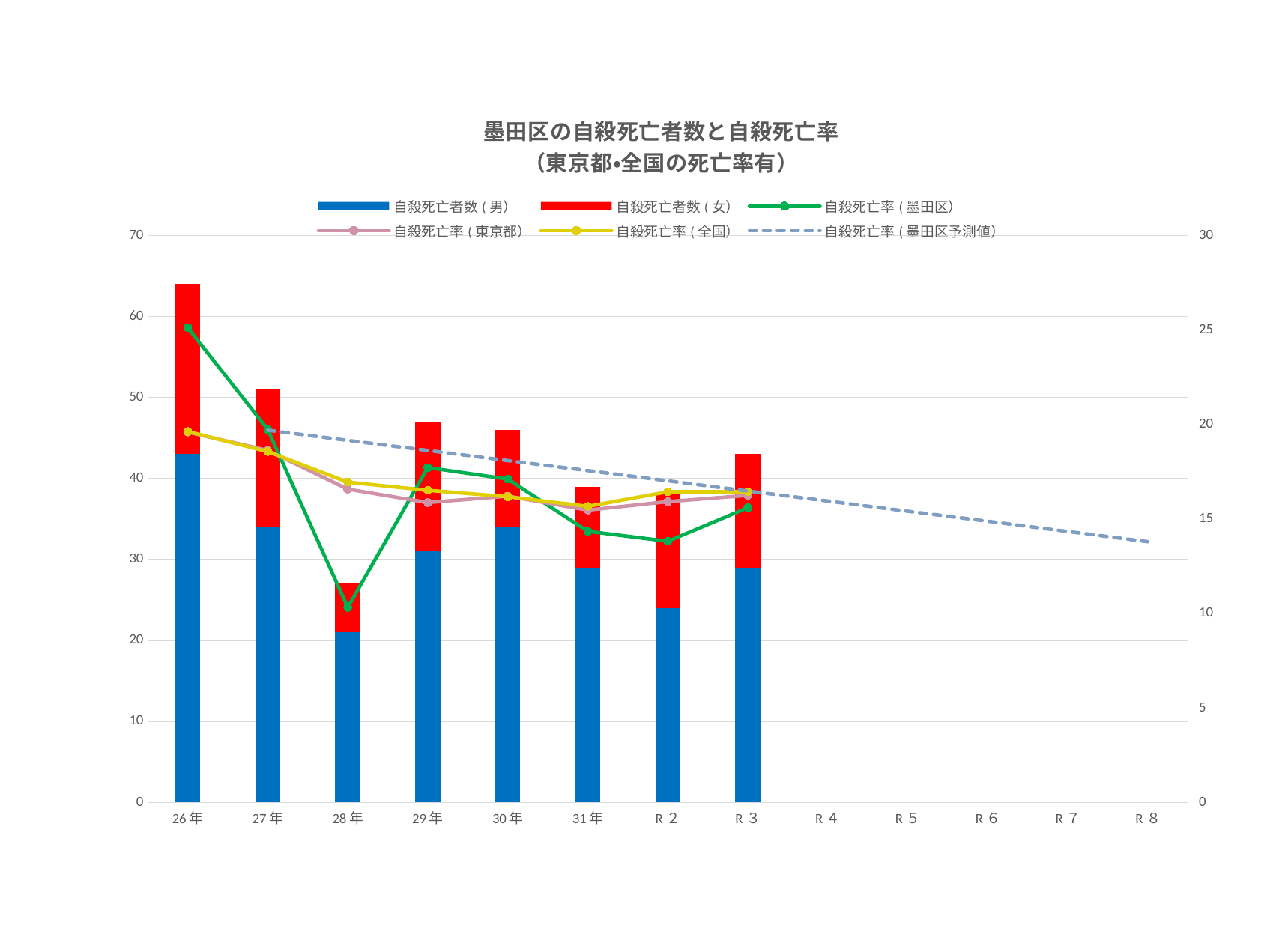
In which year does the 自殺死亡率(墨田区) line reach its lowest point? 28年 How many categories are shown on the x axis? 13 Is the total stacked bar for 28年 greater or less than 30? less How many series does the legend list? 6 What kind of chart is shown on the slide? A combined bar and line chart Which year has the shortest stacked bar (lowest total number of suicide deaths)? 28年 Which stacked bar is taller, 27年 or 31年? 27年 Is the 自殺死亡率(墨田区) value for 26年 greater or less than 20 on the right axis? greater How many years have stacked bars plotted? 8 Is the total stacked bar for 26年 greater or less than 60? greater Does the dashed 自殺死亡率(墨田区予測値) line rise or fall from 27年 to R8? fall Which year has the tallest stacked bar (highest total number of suicide deaths)? 26年